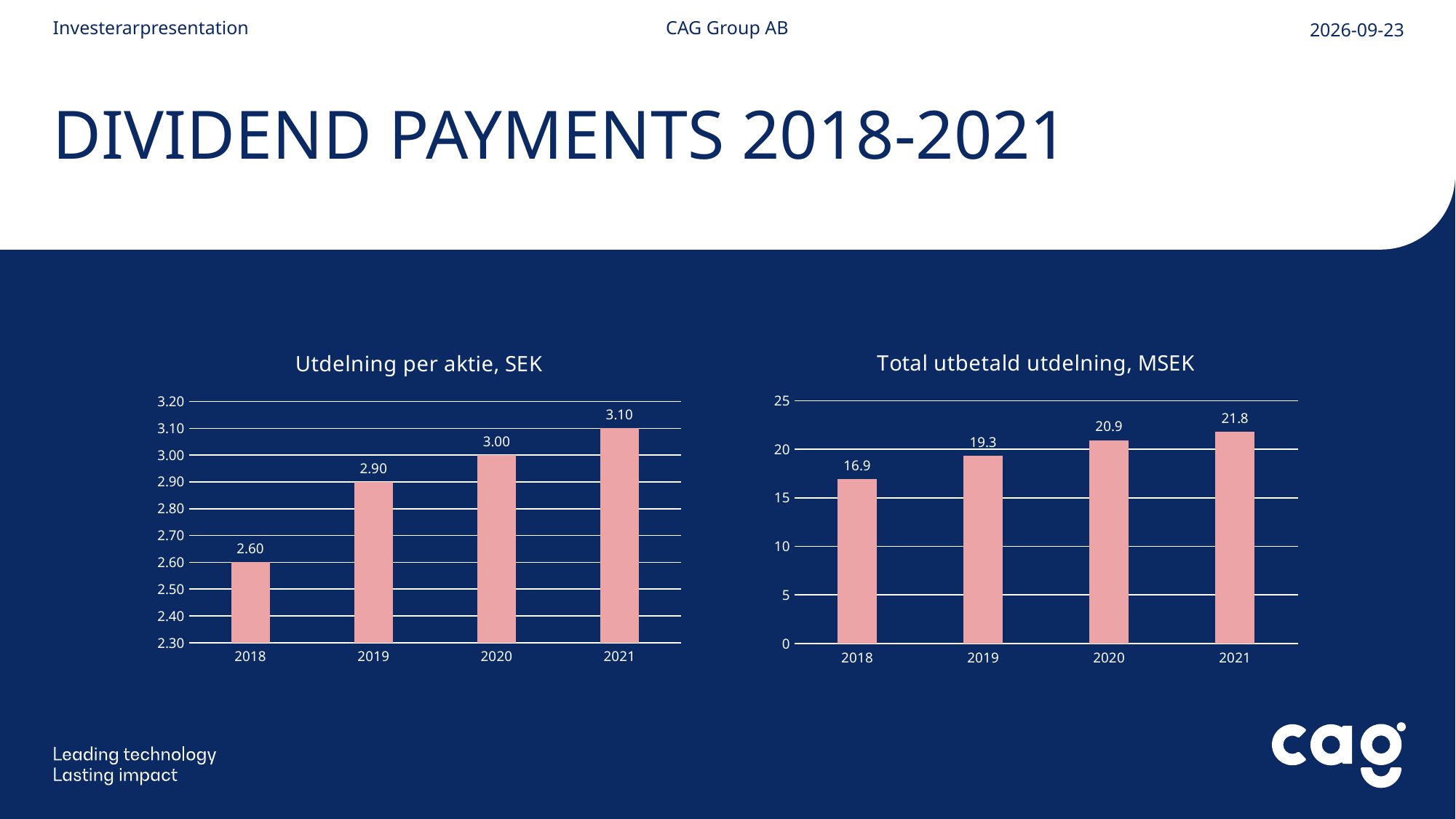
In the 'Utdelning per aktie, SEK' chart, what is the difference between the 2021 and 2018 values? 0.50 In the 'Total utbetald utdelning, MSEK' chart, which is larger, the value for 2019 or the value for 2018? 2019 In the 'Utdelning per aktie, SEK' chart, do the values rise or fall from 2018 to 2021? rise In the 'Total utbetald utdelning, MSEK' chart, what is the value for 2020? 20.9 In the 'Utdelning per aktie, SEK' chart, which year has the highest value? 2021 In the 'Utdelning per aktie, SEK' chart, what is the value for 2019? 2.90 What kind of chart is the 'Total utbetald utdelning, MSEK' chart? bar chart How many years are shown in the 'Utdelning per aktie, SEK' chart? 4 In the 'Total utbetald utdelning, MSEK' chart, is the value for 2018 greater or less than 20? less In the 'Total utbetald utdelning, MSEK' chart, which year has the lowest value? 2018 In the 'Total utbetald utdelning, MSEK' chart, what is the difference between the 2021 and 2020 values? 0.9 What is the title of the chart on the right side of the slide? Total utbetald utdelning, MSEK